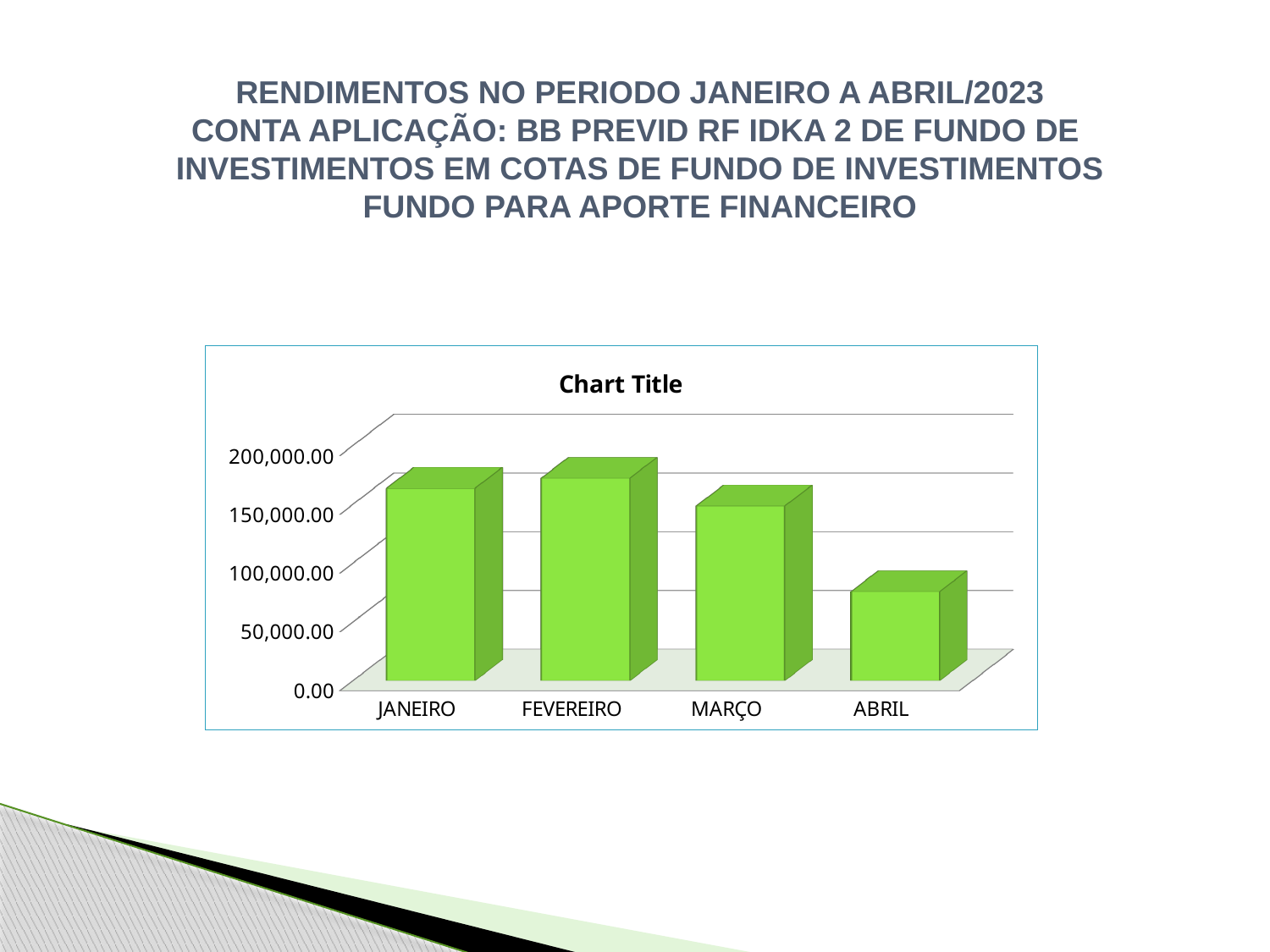
Which month has the lowest value on the chart? ABRIL What kind of chart is shown on the slide? bar chart What colour are the bars in the chart? green How many categories (months) are plotted on the chart? 4 Is the value for ABRIL greater or less than 100,000.00? less Is the value for JANEIRO greater or less than 150,000.00? greater Which is larger, the value for FEVEREIRO or the value for MARÇO? FEVEREIRO Is the value for FEVEREIRO greater or less than 200,000.00? less From FEVEREIRO to ABRIL, do the values rise or fall? fall What is the title shown on the chart itself? Chart Title Which is larger, the value for JANEIRO or the value for ABRIL? JANEIRO